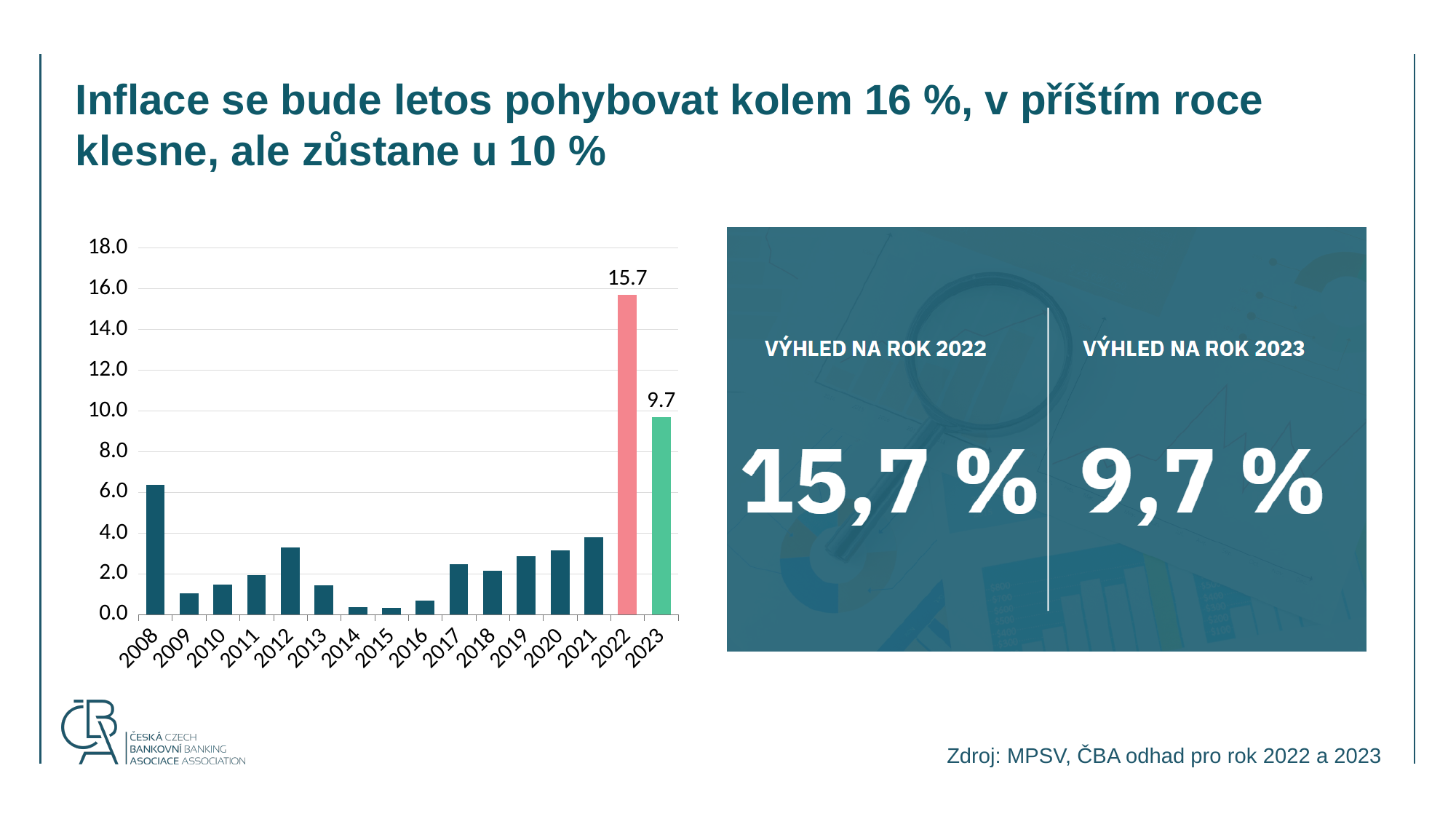
Which year has the larger value, 2022 or 2023? 2022 What is the value shown for 2022 in the bar chart? 15.7 Is the value for 2015 greater or less than 2.0? less What is the value shown for 2023 in the bar chart? 9.7 Which year has the highest bar in the chart? 2022 How many years are shown on the x axis of the chart? 16 What is the difference between the values for 2022 and 2023? 6.0 Do the values rise or fall from 2015 to 2021? rise Which year has the larger value, 2008 or 2012? 2008 Is the value for 2008 greater or less than 4.0? greater What kind of chart is shown on the slide? bar chart What colour is the bar for 2023? green